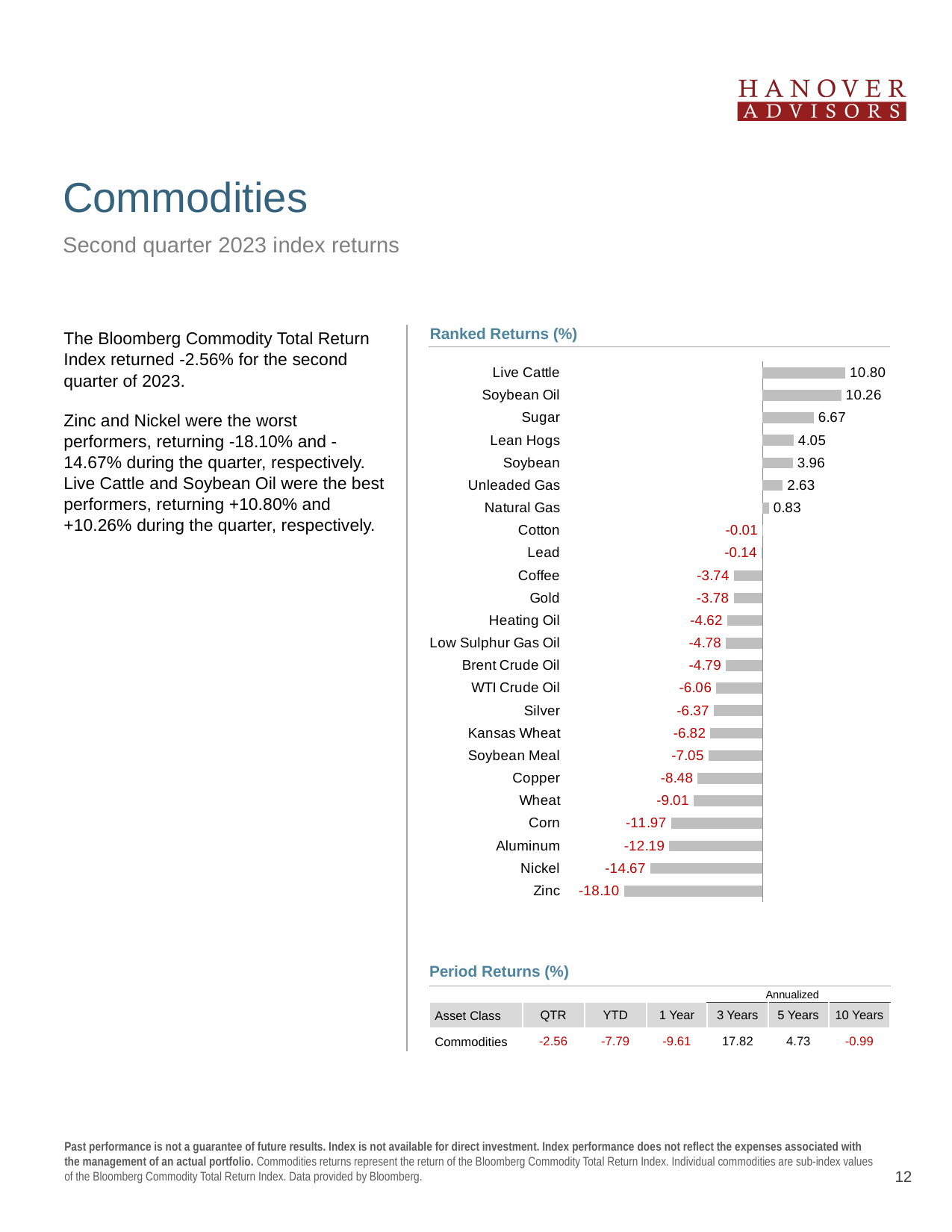
What is the difference between the values for Live Cattle and Soybean Oil in the Ranked Returns (%) chart? 0.54 What is the value for Zinc in the Ranked Returns (%) chart? -18.10 How many commodities are shown in the Ranked Returns (%) chart? 24 In the Ranked Returns (%) chart, which has the larger value, Copper or Corn? Copper What is the value for Gold in the Ranked Returns (%) chart? -3.78 What type of chart is the Ranked Returns (%) chart? Bar chart Which commodity has the highest value in the Ranked Returns (%) chart? Live Cattle Which commodity has the lowest value in the Ranked Returns (%) chart? Zinc What is the difference between the values for Nickel and Zinc in the Ranked Returns (%) chart? 3.43 What is the value for Natural Gas in the Ranked Returns (%) chart? 0.83 In the Ranked Returns (%) chart, which has the larger value, Sugar or Lean Hogs? Sugar What is the value for Live Cattle in the Ranked Returns (%) chart? 10.80